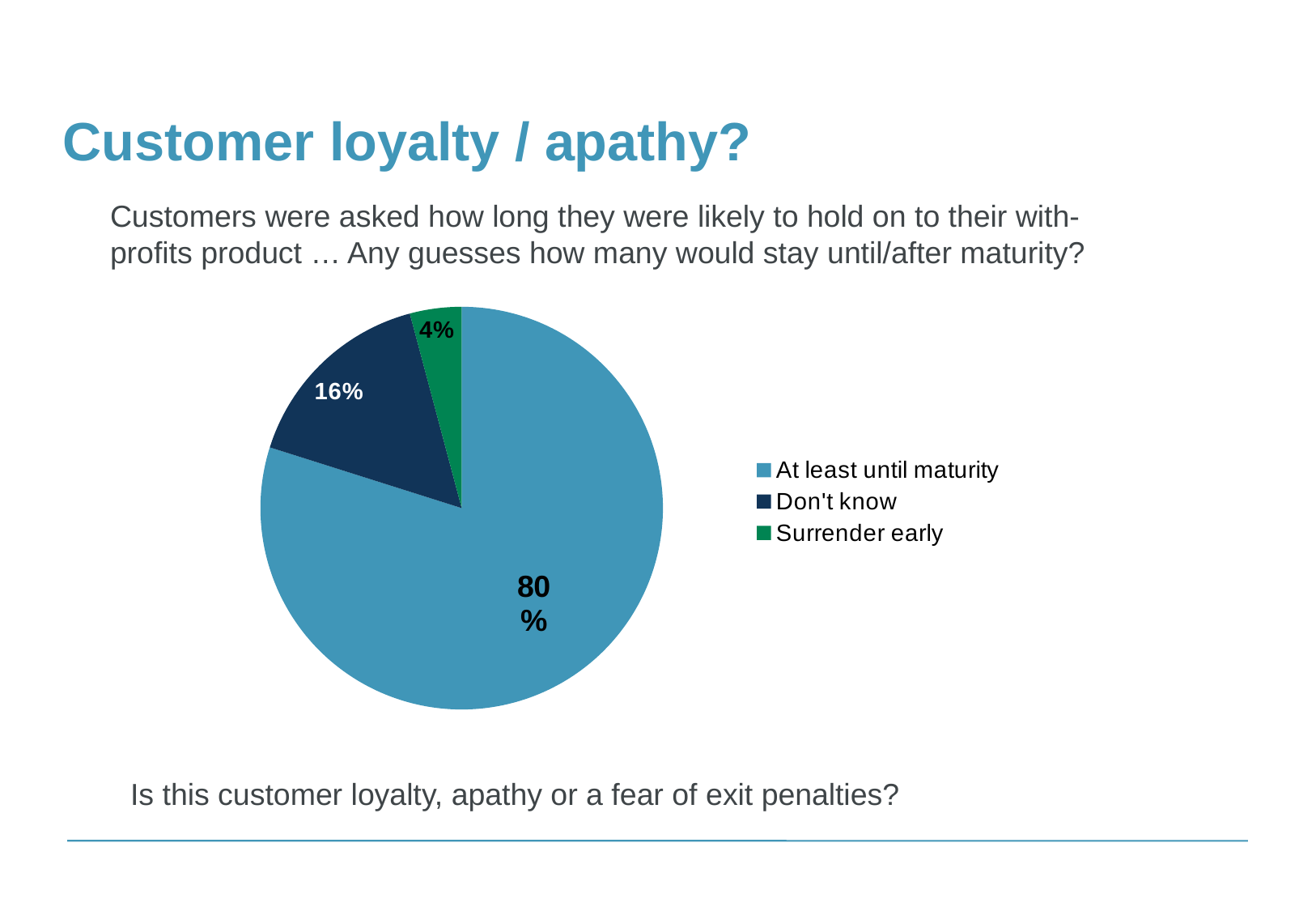
What percentage of customers said they would surrender early? 4% What share of customers said they would hold their product at least until maturity? 80% What kind of chart is shown on the slide? Pie chart How many categories does the pie chart show? 3 Which category has the smallest slice of the pie? Surrender early What percentage of customers answered "Don't know"? 16% What is the difference in percentage points between "Don't know" and "Surrender early"? 12 Which is larger: the share for "Don't know" or the share for "Surrender early"? Don't know What is the difference in percentage points between "At least until maturity" and "Don't know"? 64 Which category has the largest slice of the pie? At least until maturity What colour is the "Surrender early" slice? Green How many entries are listed in the legend? 3